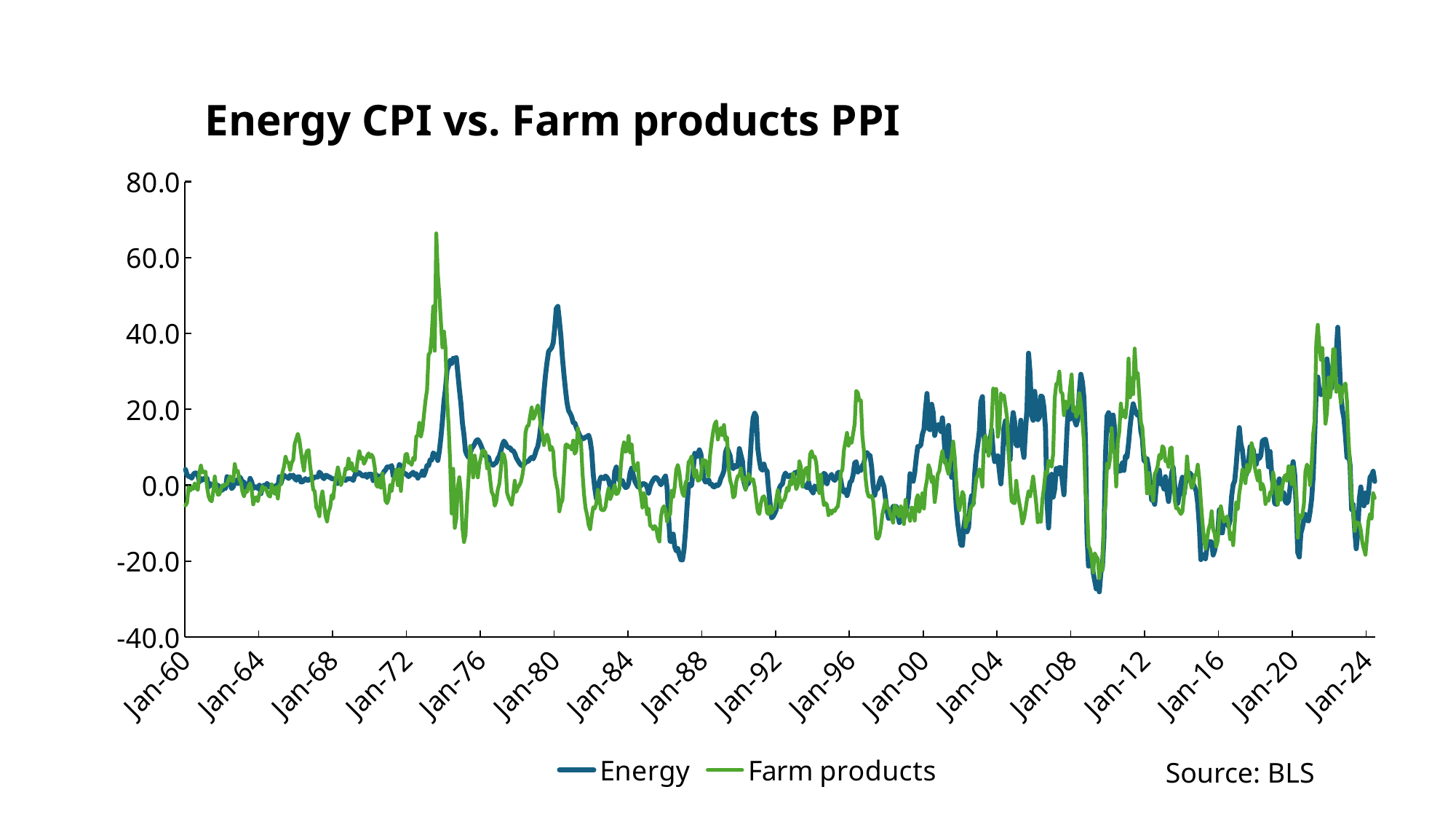
How many series does the legend list? 2 What source is cited for the chart data? BLS Is the peak value of the Farm products series around 1973-74 greater or less than 60.0? greater How many year labels are shown on the x axis? 17 Which series reaches the highest peak on the chart? Farm products What is the title of the chart? Energy CPI vs. Farm products PPI What kind of chart is shown on the slide? Line chart Which series reaches the lowest point on the chart? Energy Is the peak value of the Energy series around Jan-80 greater or less than 40.0? greater Is the lowest value of the Energy series around 2009 greater or less than -20.0? less Around Jan-80, which series has the larger value, Energy or Farm products? Energy What is the highest value shown on the y axis? 80.0